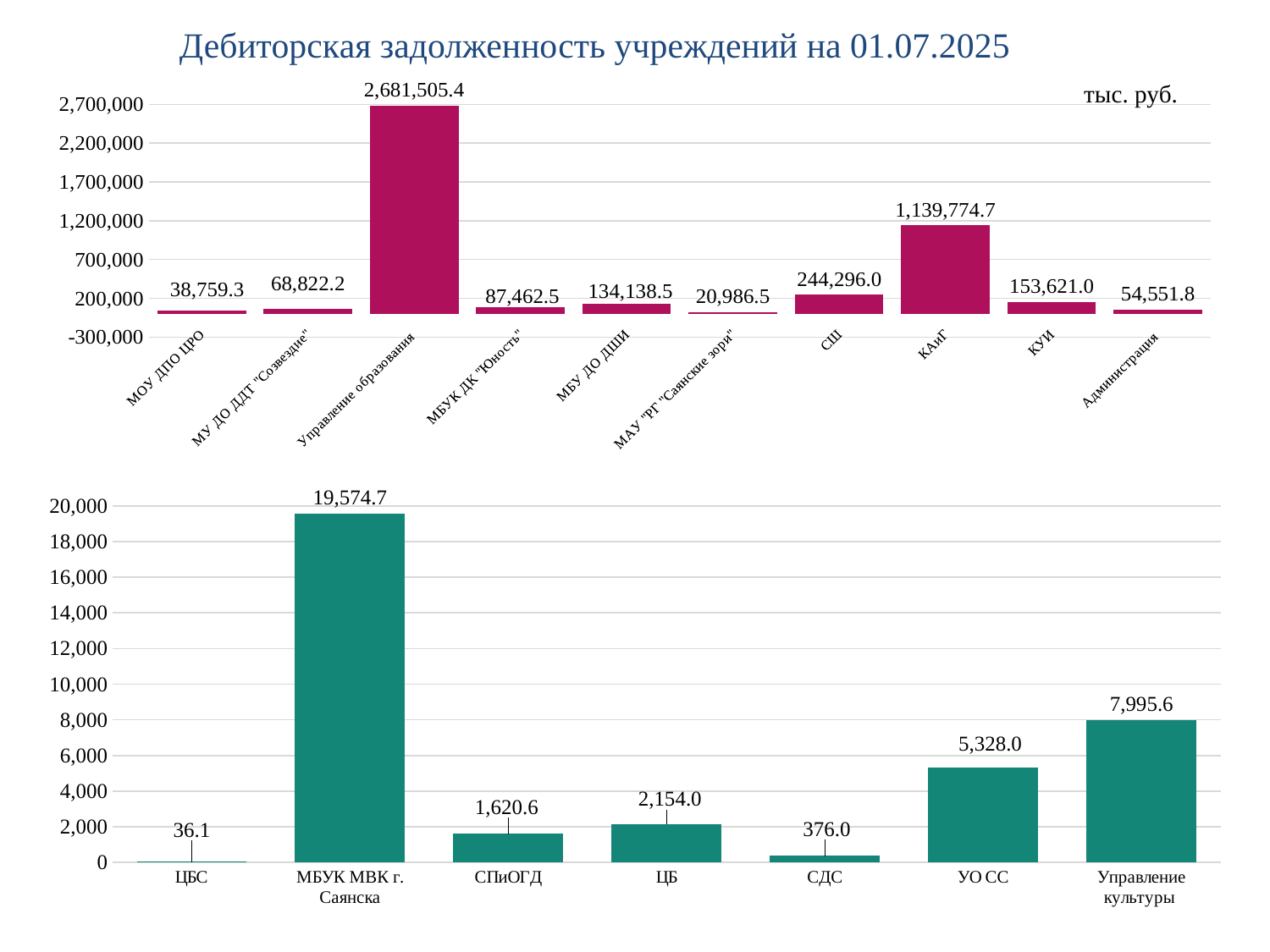
In the bottom chart, which category has the lowest value? ЦБС In the top chart, which category has the highest value? Управление образования In the top chart, how many categories are shown? 10 In the bottom chart, which category has the highest value? МБУК МВК г. Саянска In the top chart, which category has the lowest value? МАУ "РГ "Саянские зори" In the top chart, what is the difference between the values for КАиГ and СШ? 895,478.7 In the top chart, what is the value for КАиГ? 1,139,774.7 In the top chart, what is the value for СШ? 244,296.0 In the bottom chart, which is larger: the value for СПиОГД or the value for ЦБ? ЦБ In the bottom chart, what is the difference between the values for Управление культуры and УО СС? 2,667.6 What type of chart is the bottom chart? Bar chart In the bottom chart, what is the value for УО СС? 5,328.0